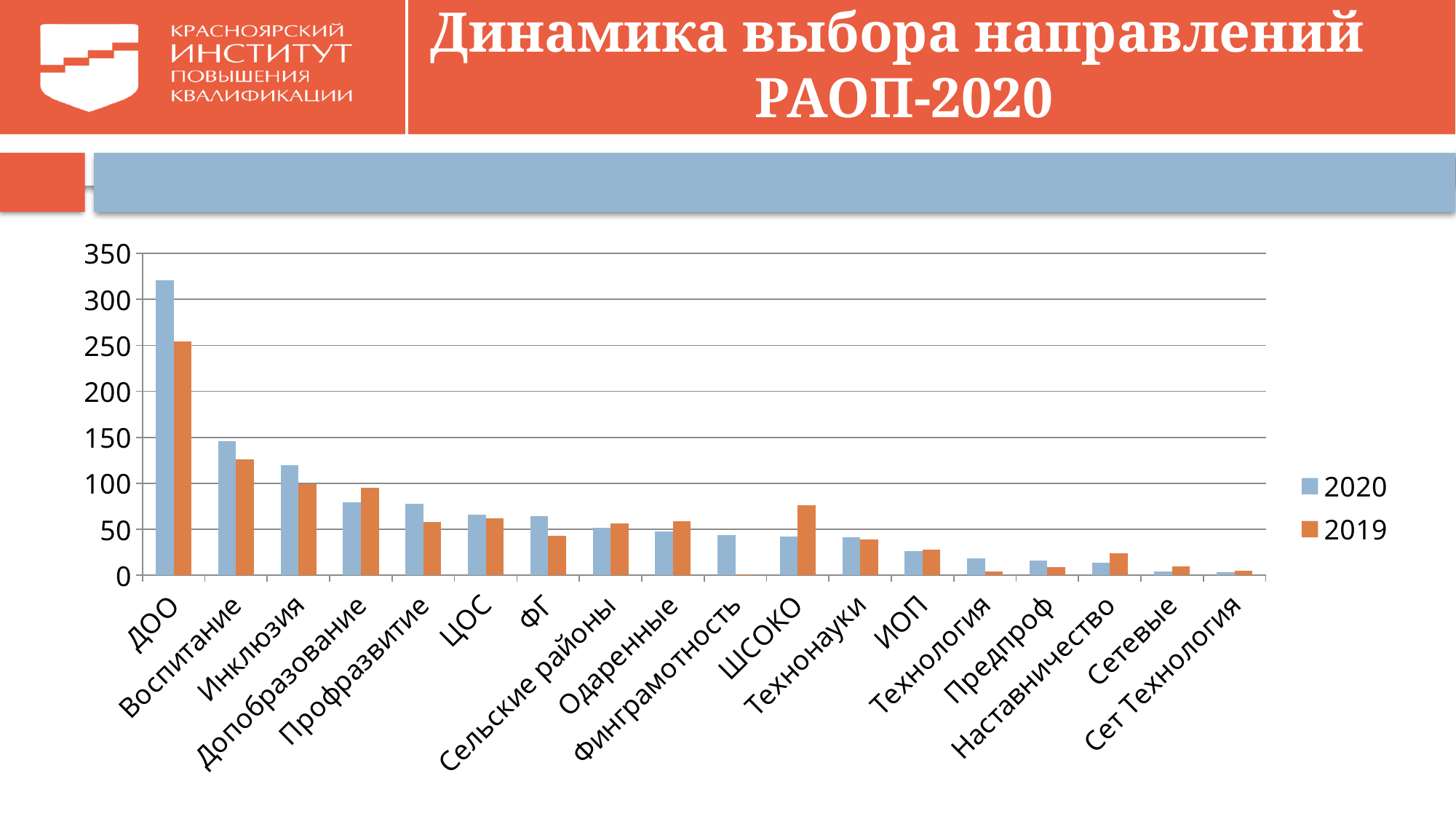
For Инклюзия, which series has the larger value, 2020 or 2019? 2020 Is the 2019 value for ДОО greater or less than 200? greater Do the 2020 values generally rise or fall from left to right along the x axis? fall How many categories are shown on the x axis? 18 For ШСОКО, which series has the larger value, 2020 or 2019? 2019 What kind of chart is shown on the slide? Bar chart How many series does the legend list? 2 Is the 2020 value for Финграмотность greater or less than 50? less Which category has the highest value for the 2020 series? ДОО Is the 2020 value for ДОО greater or less than 300? greater Which category has the highest value for the 2019 series? ДОО